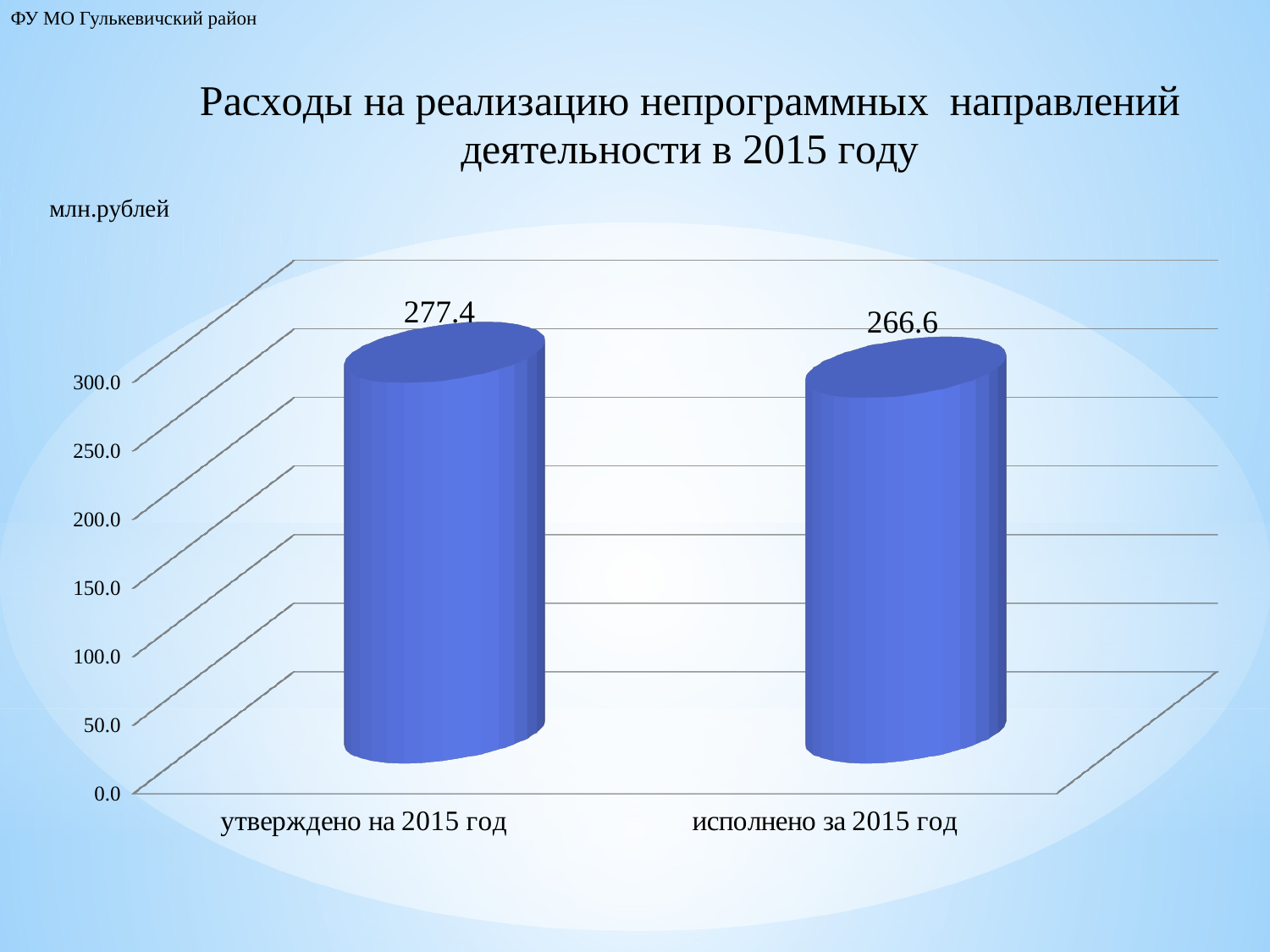
Which category has the lowest value? исполнено за 2015 год What is the title of the chart? Расходы на реализацию непрограммных направлений деятельности в 2015 году Which category has the highest value? утверждено на 2015 год What unit of measurement is indicated for the chart values? млн.рублей How many categories are shown on the chart? 2 Is the value for "утверждено на 2015 год" greater or less than 300.0? less What is the difference between the value for "утверждено на 2015 год" and the value for "исполнено за 2015 год"? 10.8 Is the value for "исполнено за 2015 год" greater or less than 250.0? greater Which is larger: the value for "утверждено на 2015 год" or the value for "исполнено за 2015 год"? утверждено на 2015 год What kind of chart is shown on the slide? bar chart What is the value for "утверждено на 2015 год"? 277.4 What is the value for "исполнено за 2015 год"? 266.6